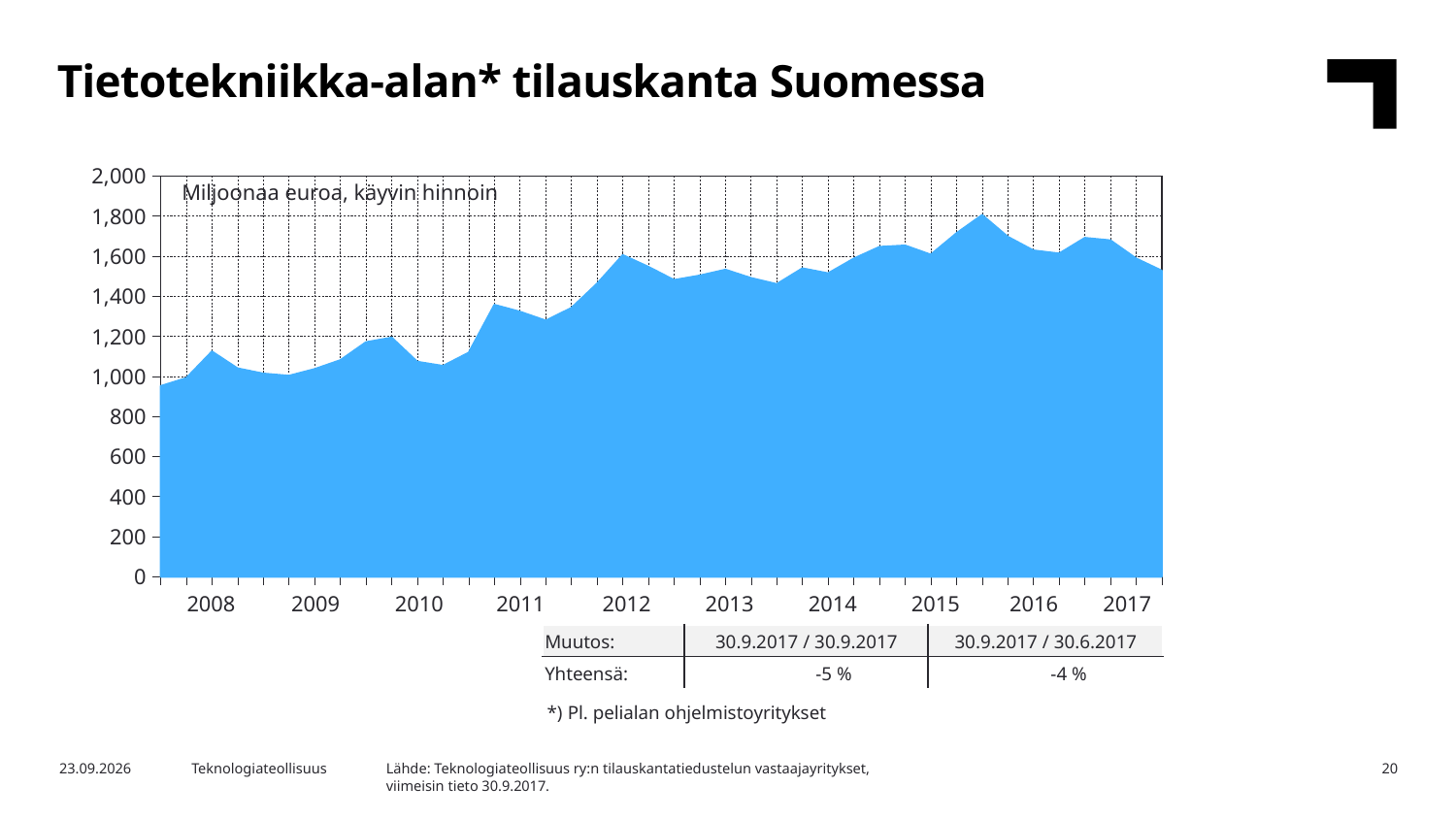
How many year labels are shown on the x axis? 10 What is the title of the chart? Tietotekniikka-alan* tilauskanta Suomessa Is the value at the start of 2012 greater or less than 1,400? greater Is the value at the start of 2010 greater or less than 1,400? less Overall, do the values rise or fall from 2008 to 2017? rise What is the highest value shown on the y axis? 2,000 Which is larger, the value at the start of 2008 or the value at the start of 2014? 2014 Is the peak value reached between 2015 and 2016 greater or less than 1,600? greater What unit is stated inside the chart area? Miljoonaa euroa, käyvin hinnoin What kind of chart is shown on the slide? area chart